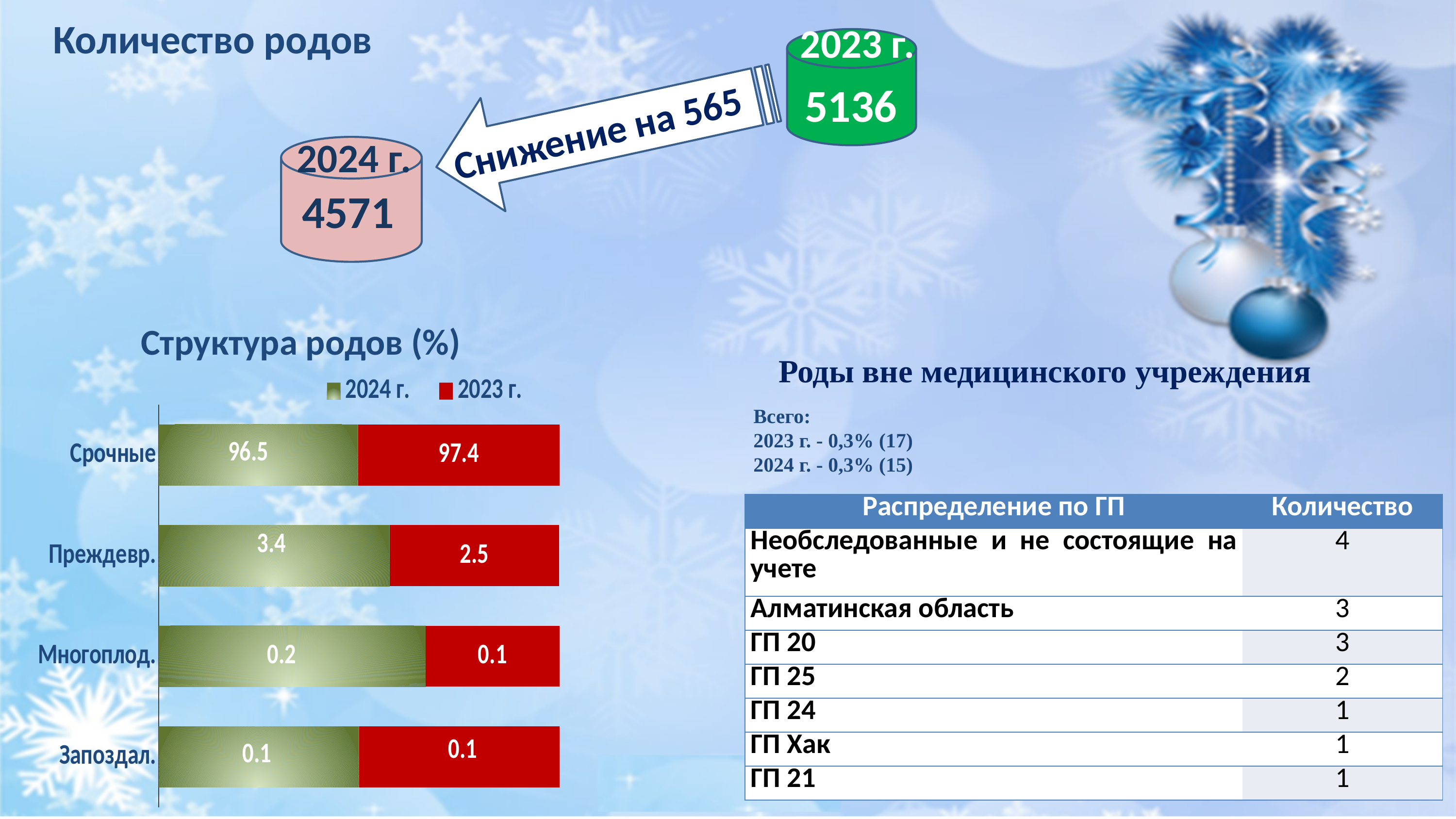
In the "Структура родов (%)" chart, which category has the highest value for 2024 г.? Срочные In the "Структура родов (%)" chart, which colour represents the 2023 г. series? red In the "Структура родов (%)" chart, what is the value for Преждевр. in 2024 г.? 3.4 In the "Структура родов (%)" chart, what is the difference between the 2023 г. and 2024 г. values for Срочные? 0.9 In the "Структура родов (%)" chart, what is the value for Срочные in 2023 г.? 97.4 What kind of chart is "Структура родов (%)"? bar chart How many categories are shown in the "Структура родов (%)" chart? 4 In the "Структура родов (%)" chart, which category has the lowest value for 2024 г.? Запоздал. In the "Структура родов (%)" chart, which is larger for Преждевр.: the 2024 г. value or the 2023 г. value? 2024 г. How many series does the legend of the "Структура родов (%)" chart list? 2 In the "Структура родов (%)" chart, what is the value for Многоплод. in 2023 г.? 0.1 In the "Структура родов (%)" chart, what is the value for Срочные in 2024 г.? 96.5